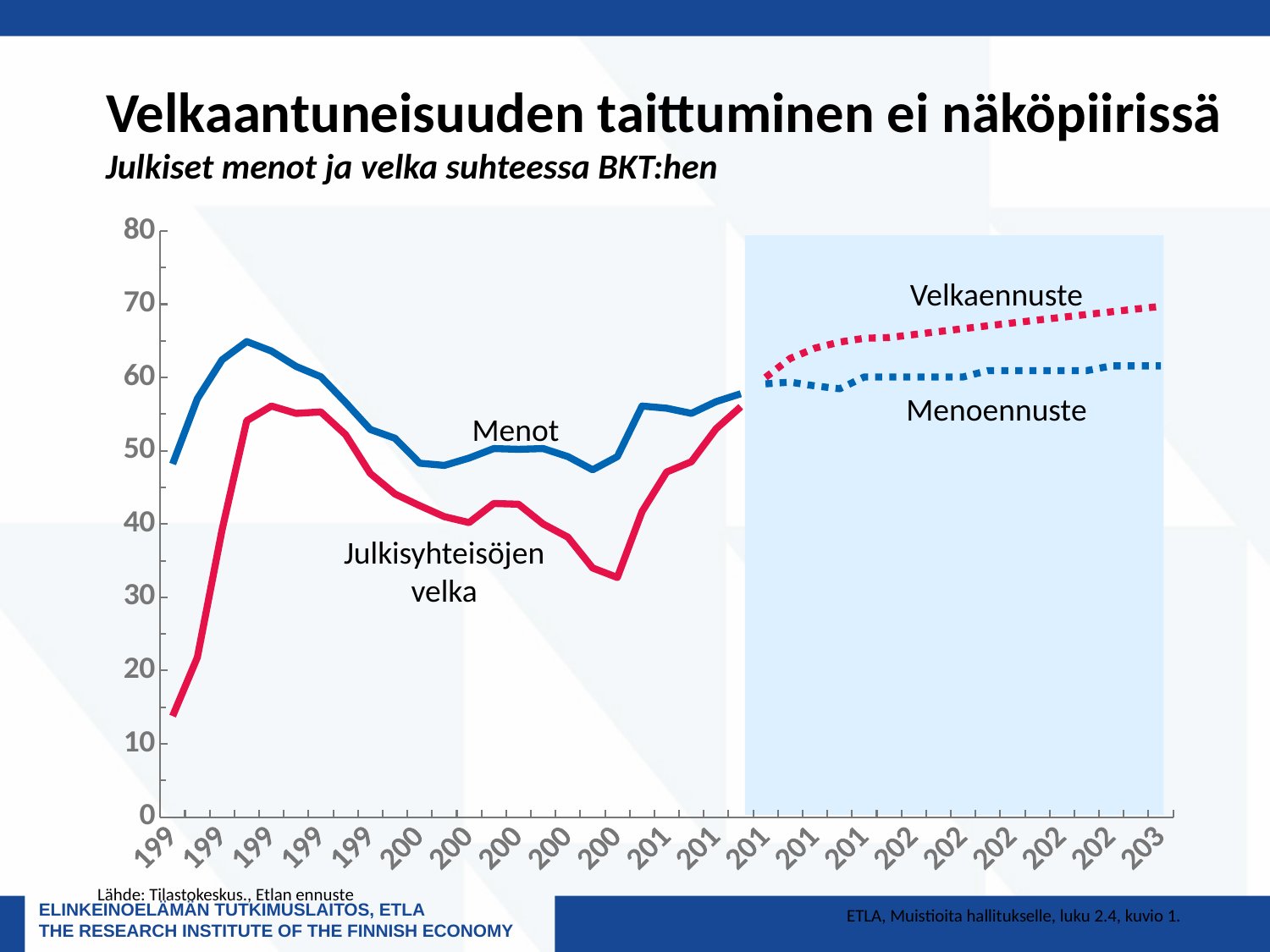
Is the final value of the Velkaennuste line greater or less than 60? greater What kind of chart is shown on the slide? line chart Is the final value of the Menoennuste line greater or less than 50? greater At the right end of the forecast period, which is higher: Velkaennuste or Menoennuste? Velkaennuste What is the title of the slide above the chart? Velkaantuneisuuden taittuminen ei näköpiirissä Is the starting value of the Julkisyhteisöjen velka line greater or less than 20? less Which series reaches the lowest value anywhere on the chart? Julkisyhteisöjen velka Does the Velkaennuste line rise or fall across the forecast period? rise How many labelled series are plotted on the chart? 4 What colour is the Menot line? blue